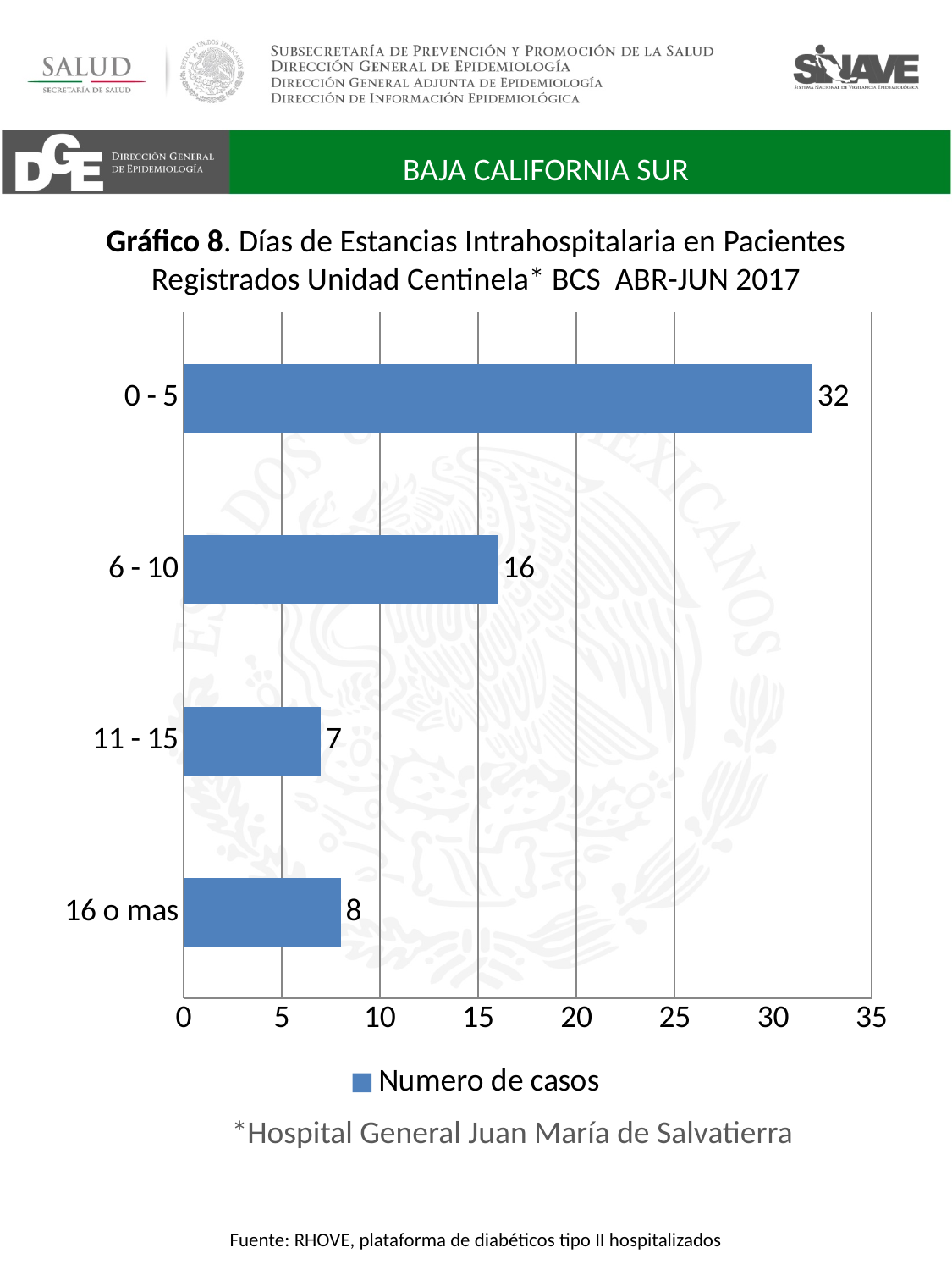
How many series does the legend list? 1 What is the number of cases for the 6 - 10 days category? 16 Which has more cases, 16 o mas or 11 - 15? 16 o mas Which category has the highest number of cases? 0 - 5 What is the number of cases for the 0 - 5 days category? 32 How many categories are shown in the chart? 4 What is the number of cases for the 16 o mas category? 8 What kind of chart is shown on the slide? Bar chart What is the difference in number of cases between the 0 - 5 and 6 - 10 categories? 16 Which category has the lowest number of cases? 11 - 15 What is the legend entry for the series in the chart? Numero de casos What is the number of cases for the 11 - 15 days category? 7